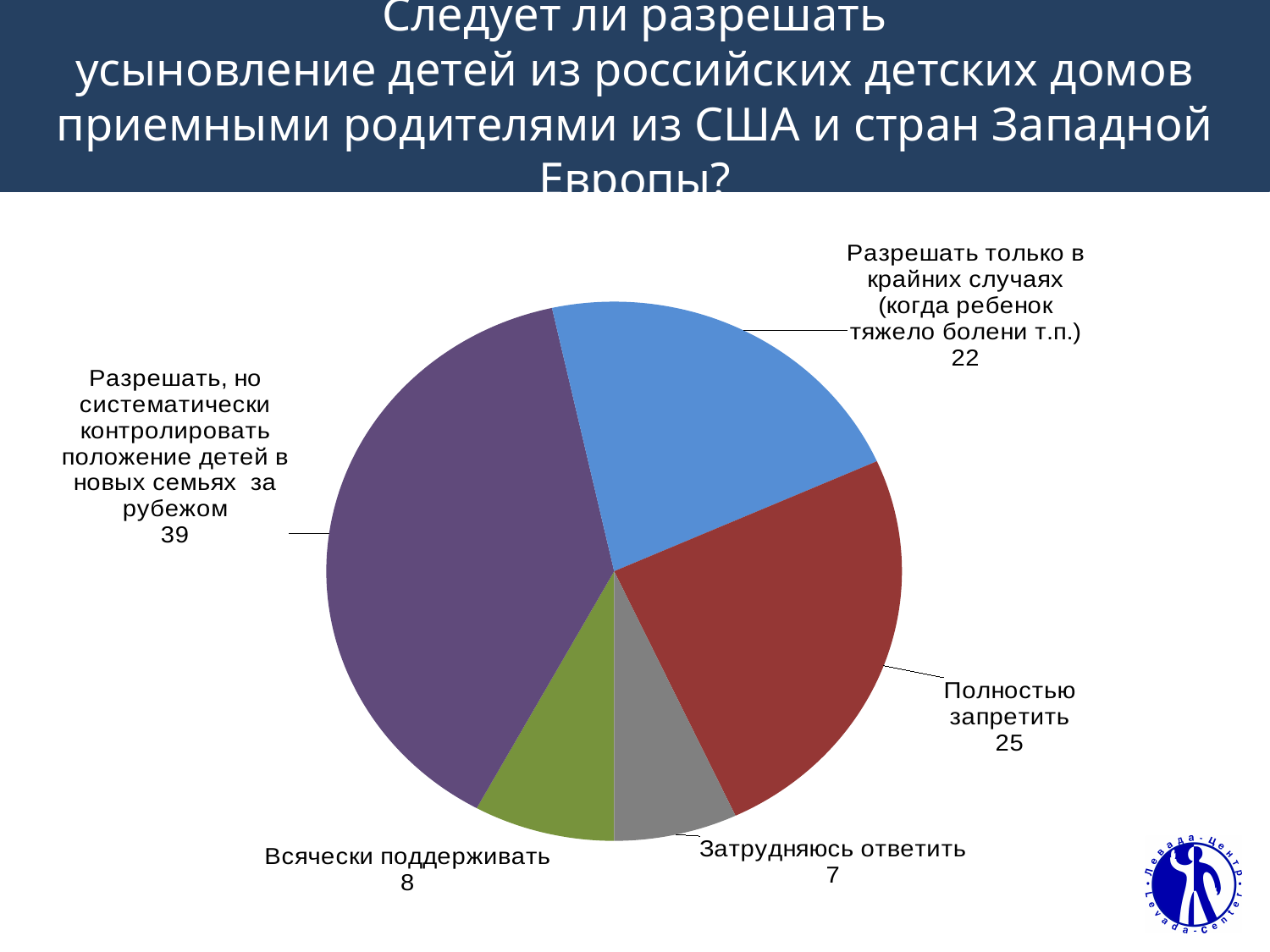
What is the value for "Разрешать только в крайних случаях"? 22 Which is larger: the value for "Полностью запретить" or the value for "Разрешать только в крайних случаях"? Полностью запретить What is the value for "Полностью запретить"? 25 What is the value for "Всячески поддерживать"? 8 What colour is the slice for "Полностью запретить"? red What is the value for "Затрудняюсь ответить"? 7 Which category has the smallest slice of the pie? Затрудняюсь ответить What is the difference between the values for "Всячески поддерживать" and "Затрудняюсь ответить"? 1 What type of chart is shown on the slide? pie chart How many slices does the pie chart have? 5 Which category has the largest slice of the pie? Разрешать, но систематически контролировать положение детей в новых семьях за рубежом What is the difference between the values for "Разрешать, но систематически контролировать..." (39) and "Полностью запретить" (25)? 14